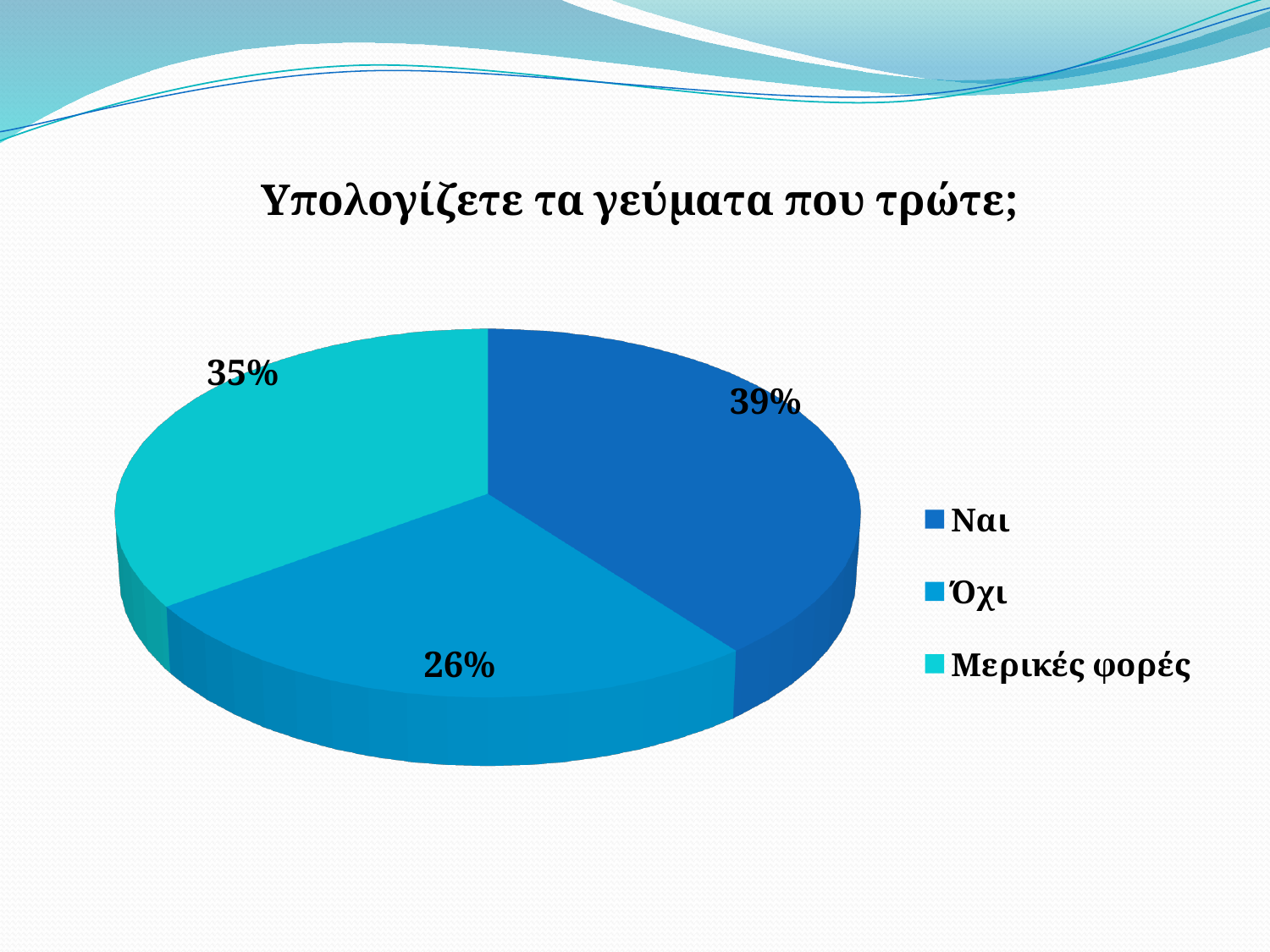
What is the title of the chart? Υπολογίζετε τα γεύματα που τρώτε; What is the difference in percentage points between "Ναι" and "Όχι"? 13 Which is larger, the share for "Μερικές φορές" or the share for "Όχι"? Μερικές φορές How many entries does the legend list? 3 What percentage of the pie is labelled for "Όχι"? 26% What percentage of the pie is labelled for "Μερικές φορές"? 35% What kind of chart is shown on the slide? Pie chart Which category has the smallest share of the pie? Όχι Which category has the largest share of the pie? Ναι What is the share of the pie taken by "Μερικές φορές"? 35% How many slices does the pie chart have? 3 What percentage of the pie is labelled for "Ναι"? 39%